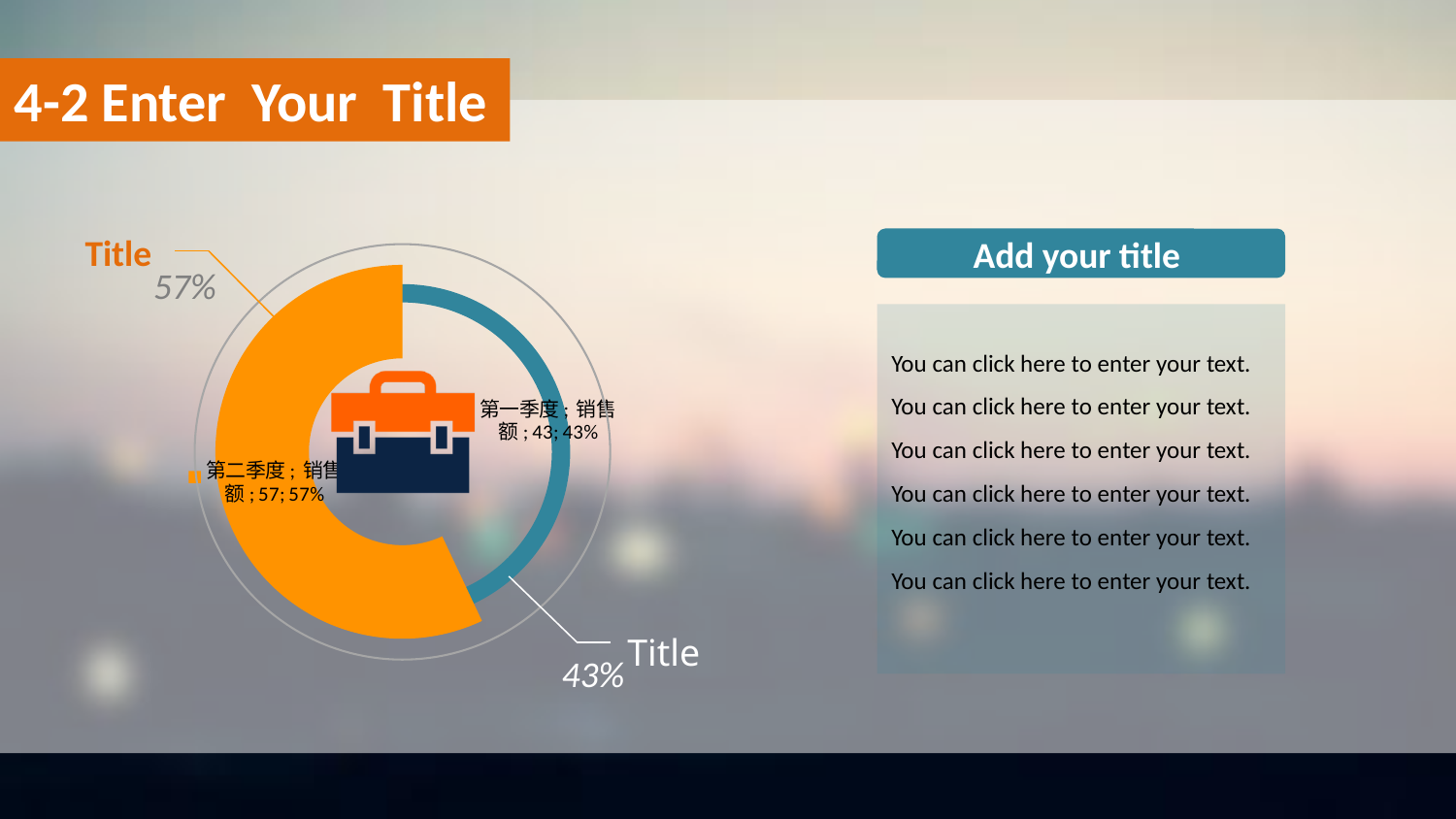
Is the value for 第二季度 larger or smaller than the value for 第一季度? larger What colour is the 第二季度 slice? Orange What share of the chart does 第一季度 represent? 43% What kind of chart is shown on the slide? Pie chart (doughnut) What share of the chart does 第二季度 represent? 57% Which quarter has the smaller slice? 第一季度 How many slices does the chart have? 2 What is the difference between the 第二季度 and 第一季度 values? 14 What is the 销售额 value for 第一季度? 43 Which quarter has the larger slice? 第二季度 What colour is the 第一季度 slice? Blue What is the 销售额 value for 第二季度? 57